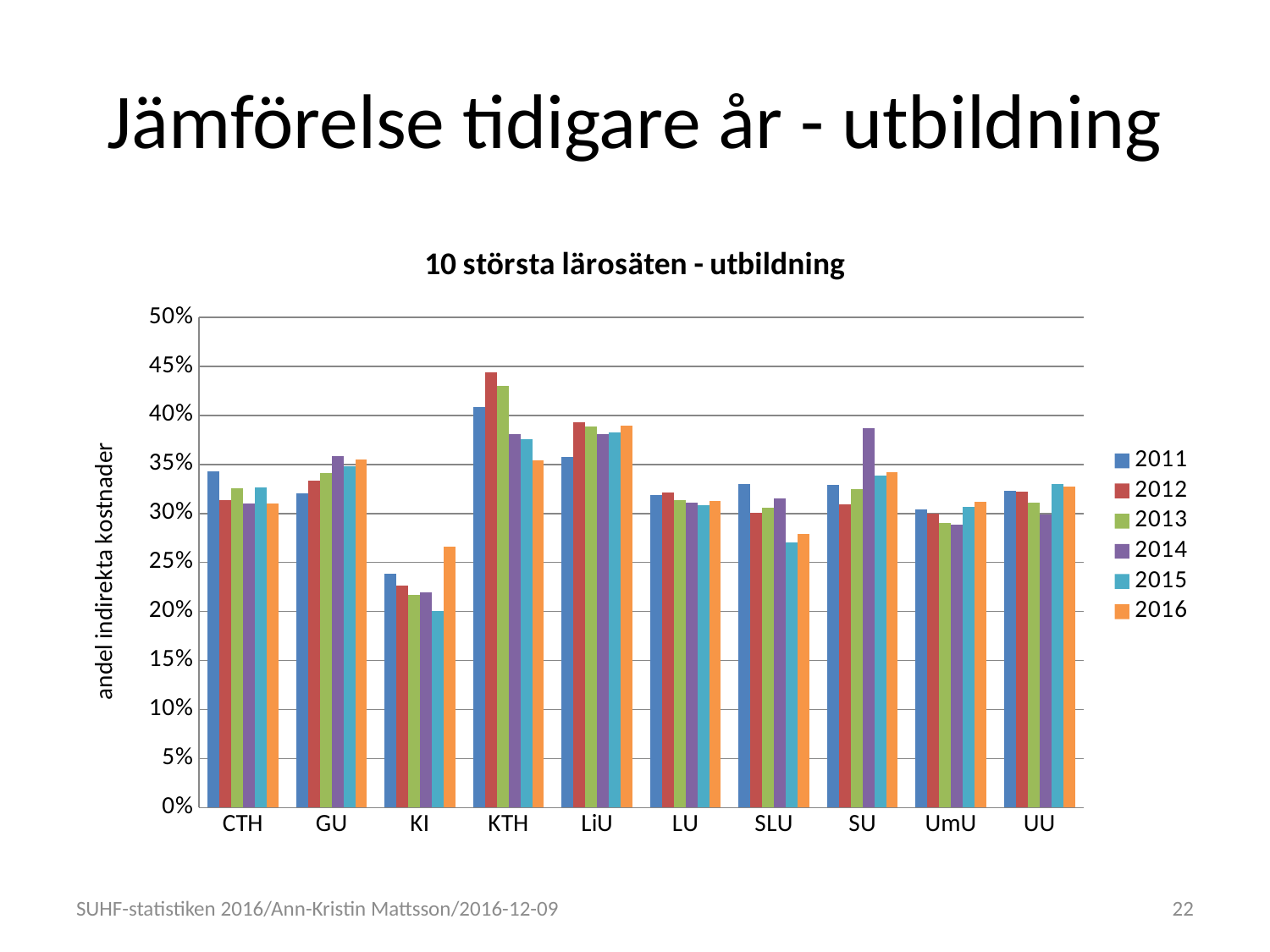
Is the value for SU in 2014 greater or less than 35%? greater Do the values for KTH rise or fall from 2012 to 2016? fall Is the value for KTH in 2012 greater or less than 40%? greater What is the title of the chart? 10 största lärosäten - utbildning What kind of chart is shown on the slide? bar chart How many series does the legend list? 6 Which institution has the highest value for 2012? KTH Is the value for KI in 2015 greater or less than 25%? less Which institution has the lowest value for 2015? KI How many institutions (categories) are shown on the x axis? 10 Which is larger for 2011: the value for KTH or the value for LiU? KTH